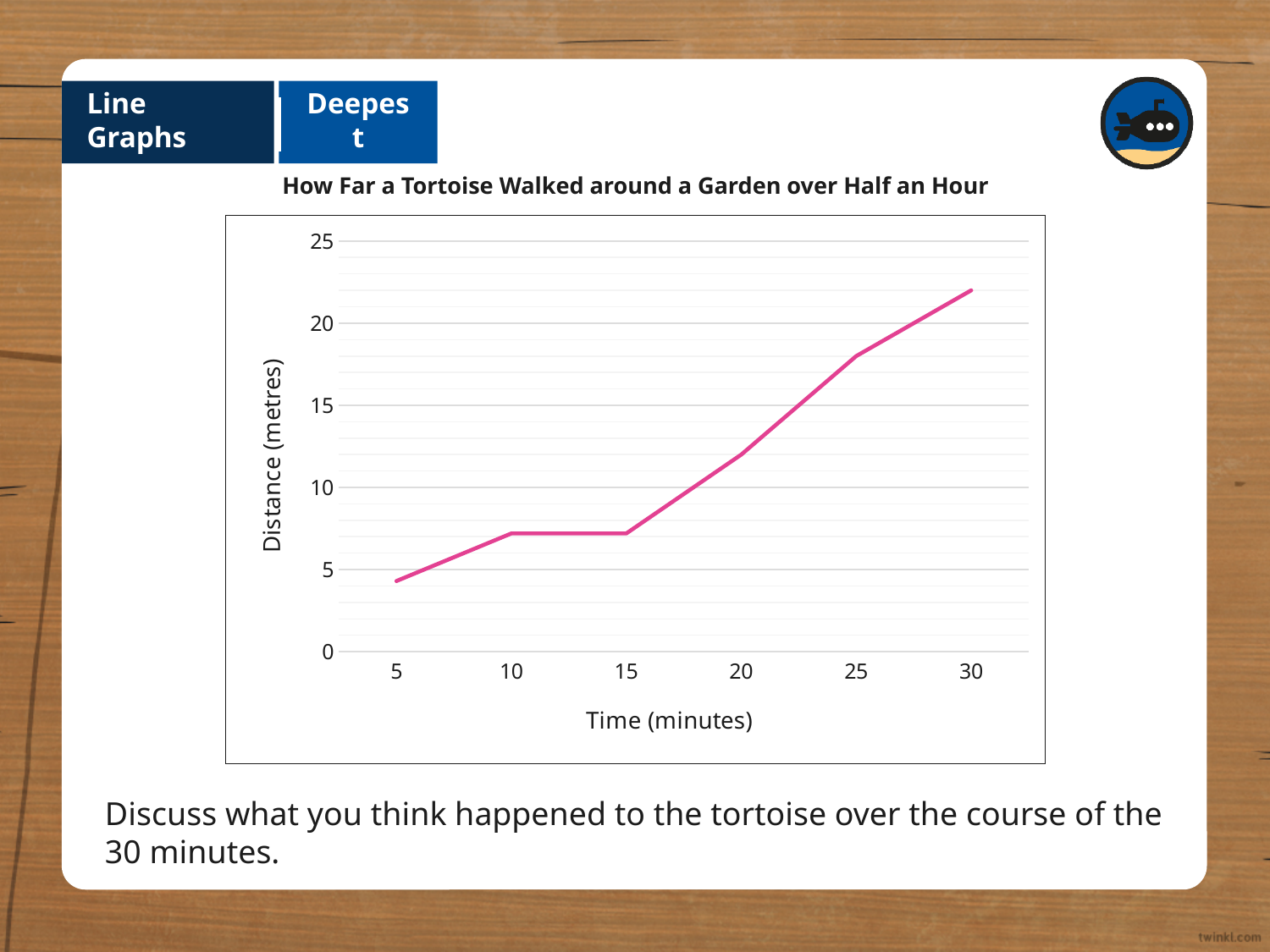
Does the distance generally rise or fall as time increases along the x axis? rise What is the title of the chart? How Far a Tortoise Walked around a Garden over Half an Hour Is the distance at 25 minutes greater or less than 15 metres? greater What kind of chart is shown on the slide? line chart At which time is the distance walked the lowest? 5 What is the label on the vertical axis of the chart? Distance (metres) At which time is the distance walked the highest? 30 Is the distance at 10 minutes greater or less than 5 metres? greater Is the distance at 15 minutes greater or less than 10 metres? less How many time points are plotted on the line? 6 Which is larger, the distance at 20 minutes or the distance at 25 minutes? 25 minutes